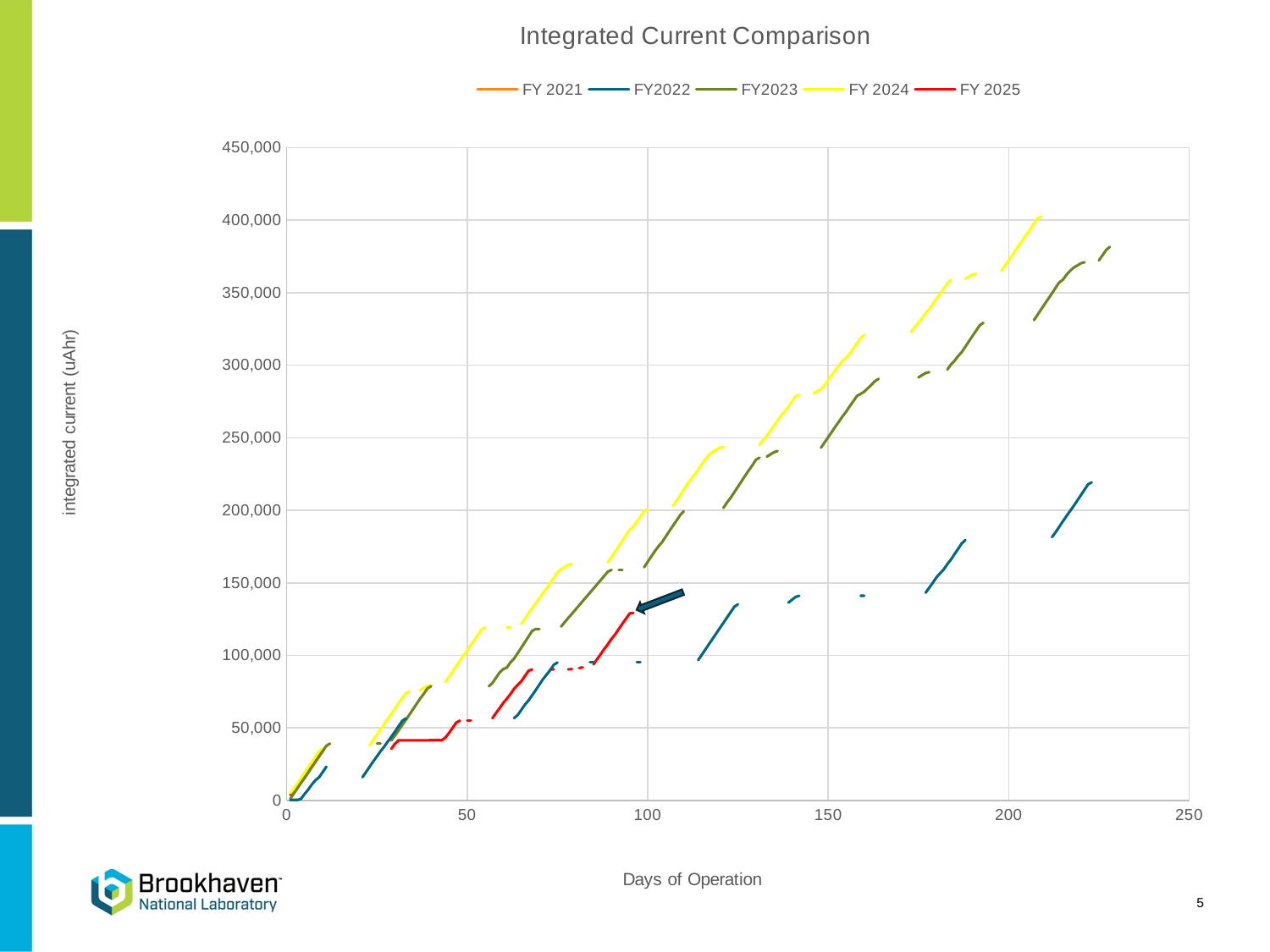
How many series does the legend list? 5 Is the final value of the FY 2025 series greater or less than 150,000? less Do the integrated current values rise or fall as days of operation increase? rise What kind of chart is shown on the slide? line chart Which series reaches the highest integrated current on the chart? FY 2024 Is the final value of the FY2022 series greater or less than 200,000? greater Is the final value of the FY2023 series greater or less than 350,000? greater At 100 days of operation, which series has the larger integrated current, FY 2024 or FY2022? FY 2024 What is the label of the y axis? integrated current (uAhr) At 150 days of operation, which series has the larger integrated current, FY 2024 or FY2023? FY 2024 What is the title of the chart? Integrated Current Comparison